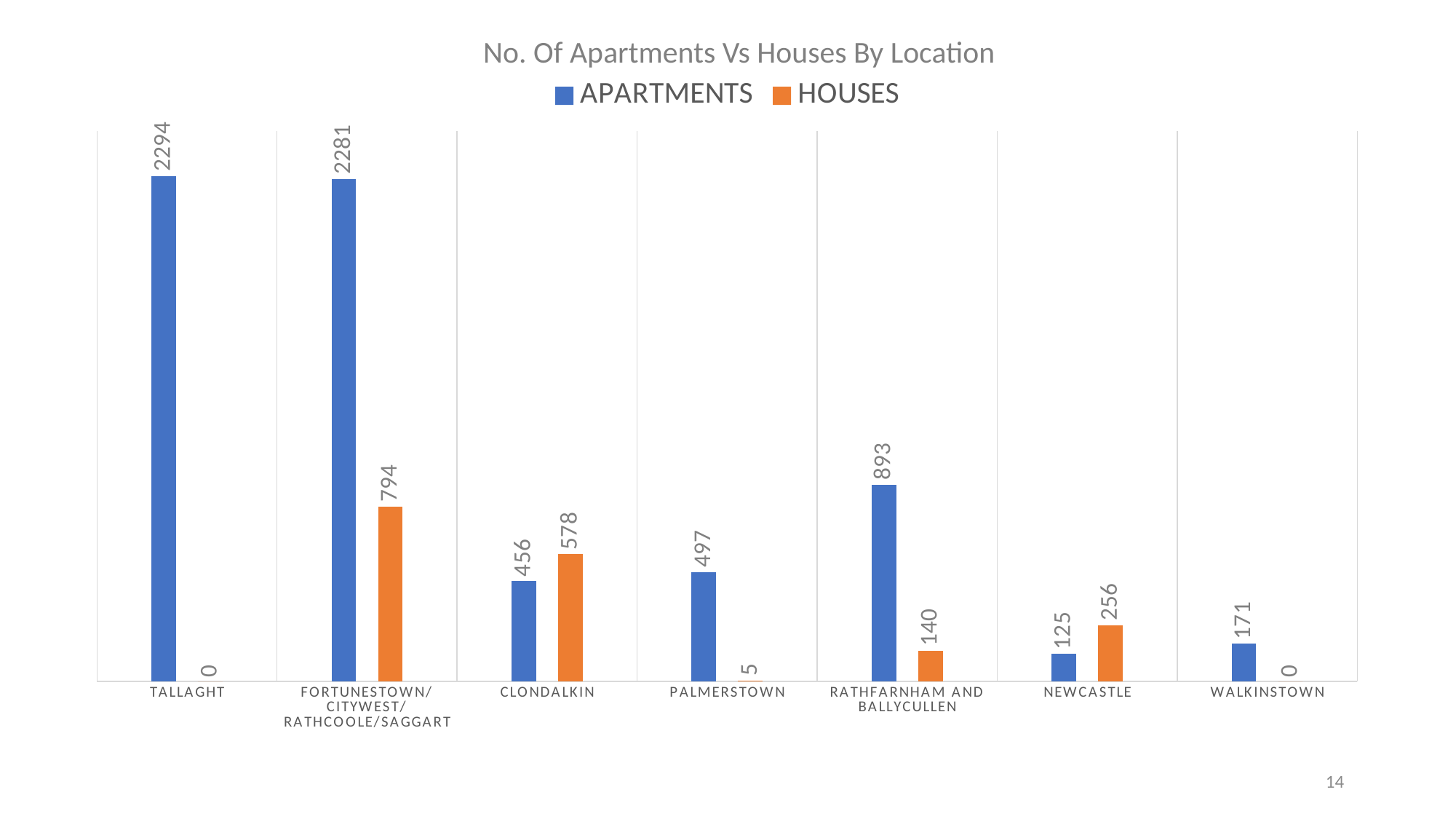
How many series does the legend list? 2 Which location has the highest number of houses? Fortunestown/Citywest/Rathcoole/Saggart Which location has the highest number of apartments? Tallaght What is the difference between the number of apartments and houses in Rathfarnham and Ballycullen? 753 Which location has the lowest number of apartments? Newcastle What is the number of apartments in Tallaght? 2294 What is the title of the chart? No. Of Apartments Vs Houses By Location What is the number of houses in Clondalkin? 578 What kind of chart is shown on the slide? Bar chart How many locations are shown on the x axis? 7 Which is larger in Clondalkin, the number of apartments or the number of houses? Houses What is the number of houses in Newcastle? 256